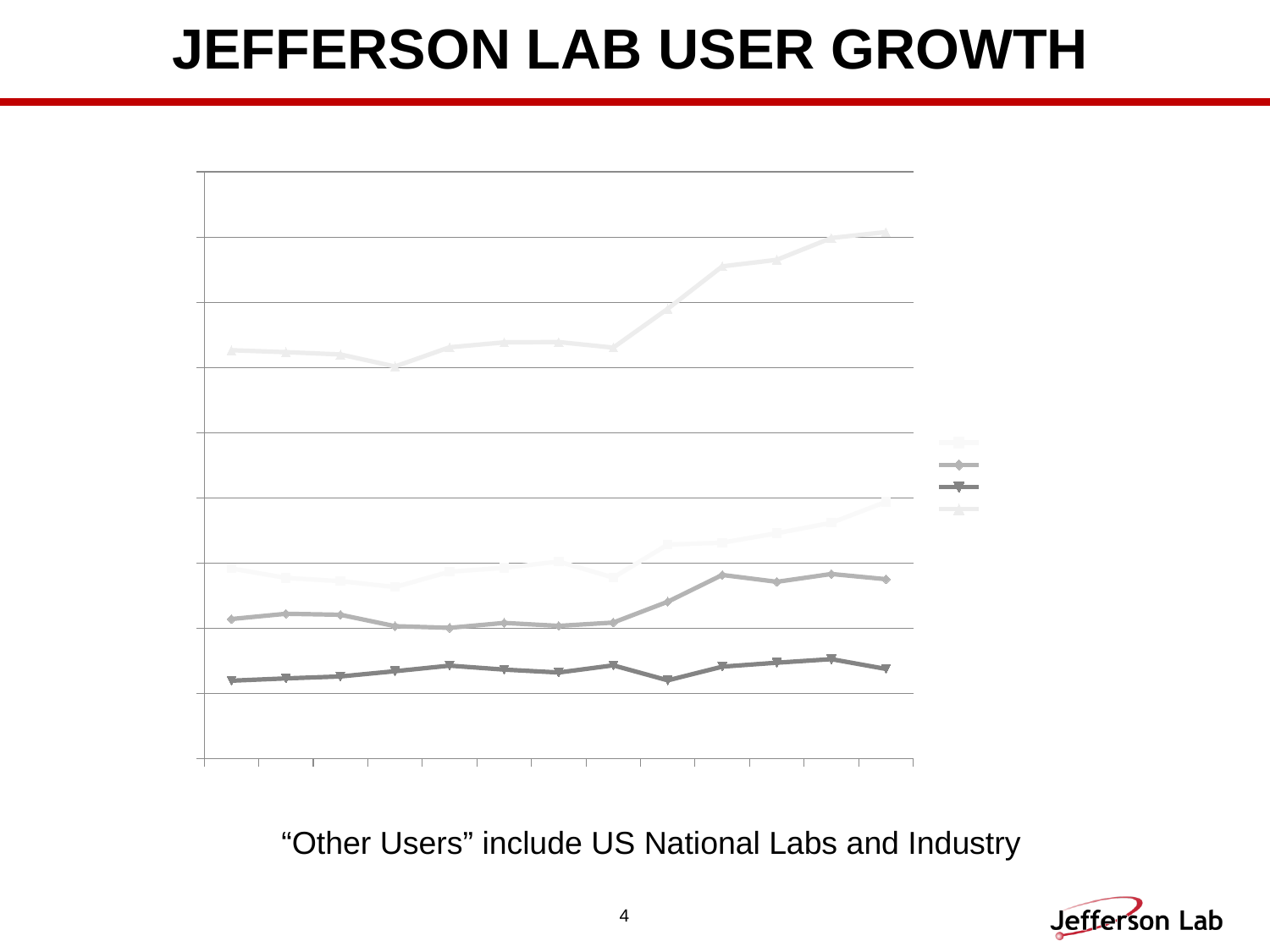
Does the second line from the top in the chart rise or fall overall from left to right? rise Where is the legend positioned relative to the plot area of the chart? to the right How many series does the chart's legend list? 4 Does the topmost line in the chart rise or fall overall from left to right? rise How many data points does each line in the chart have? 13 Which line in the chart is plotted highest on the vertical axis across all points: the topmost line or the bottommost line? the topmost line What kind of chart is shown on the slide? line chart What is the title of the slide containing the chart? JEFFERSON LAB USER GROWTH